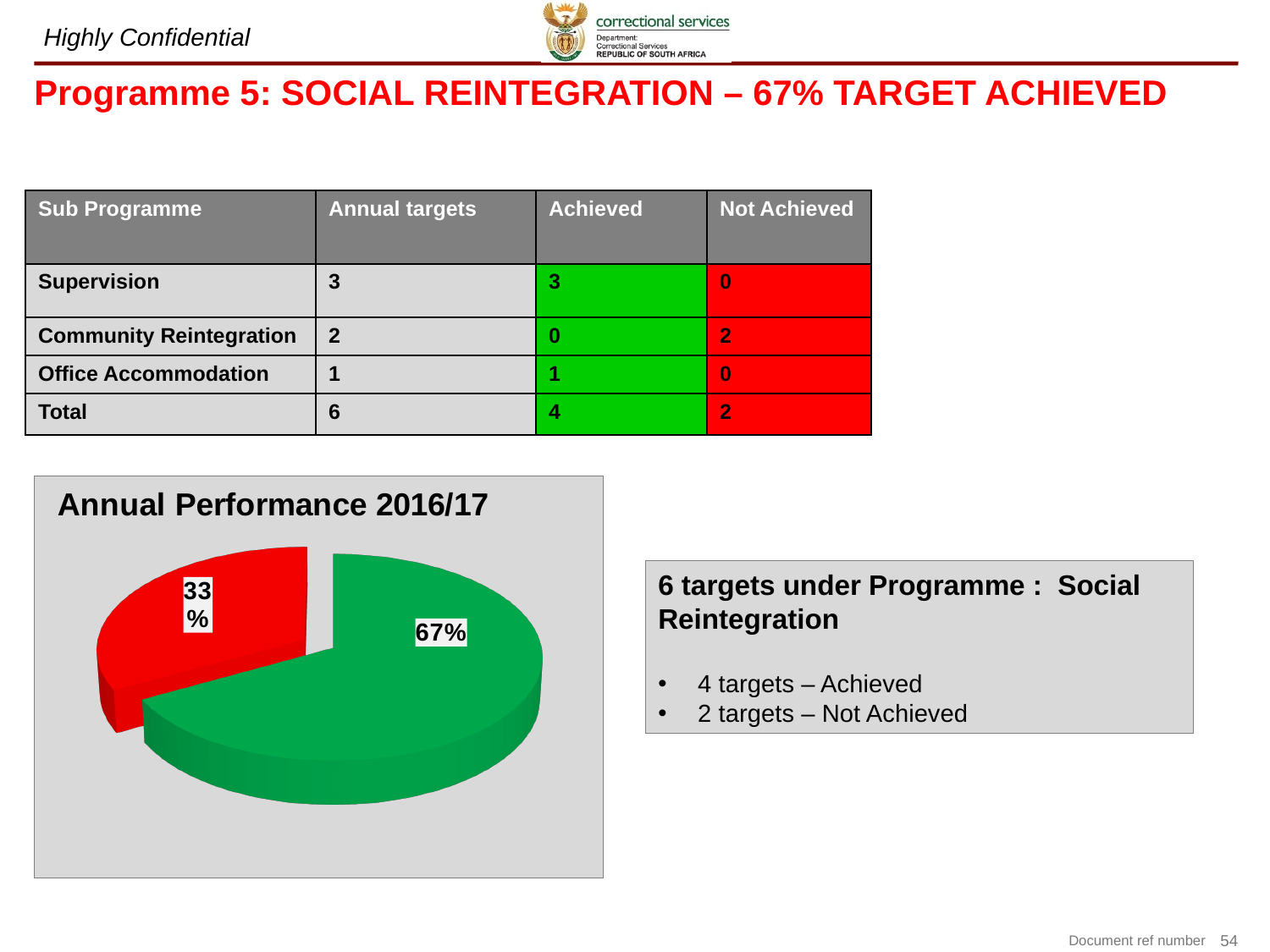
In the "Annual Performance 2016/17" pie chart, what percentage is shown on the red slice? 33% In the "Annual Performance 2016/17" pie chart, is the green slice or the red slice larger? The green slice In the "Annual Performance 2016/17" pie chart, which slice is the largest? The green slice (67%) In the "Annual Performance 2016/17" pie chart, what is the difference in percentage points between the green slice and the red slice? 34 percentage points In the "Annual Performance 2016/17" pie chart, which slice is the smallest? The red slice (33%) In the "Annual Performance 2016/17" pie chart, is the red slice's value greater or less than 50%? less How many slices does the "Annual Performance 2016/17" pie chart have? 2 What colour is the slice representing 33% in the "Annual Performance 2016/17" pie chart? Red In the "Annual Performance 2016/17" pie chart, what share of the pie does the green slice represent? 67% In the "Annual Performance 2016/17" pie chart, what percentage is shown on the green slice? 67% What kind of chart is shown under the title "Annual Performance 2016/17"? Pie chart What is the title of the pie chart on the slide? Annual Performance 2016/17